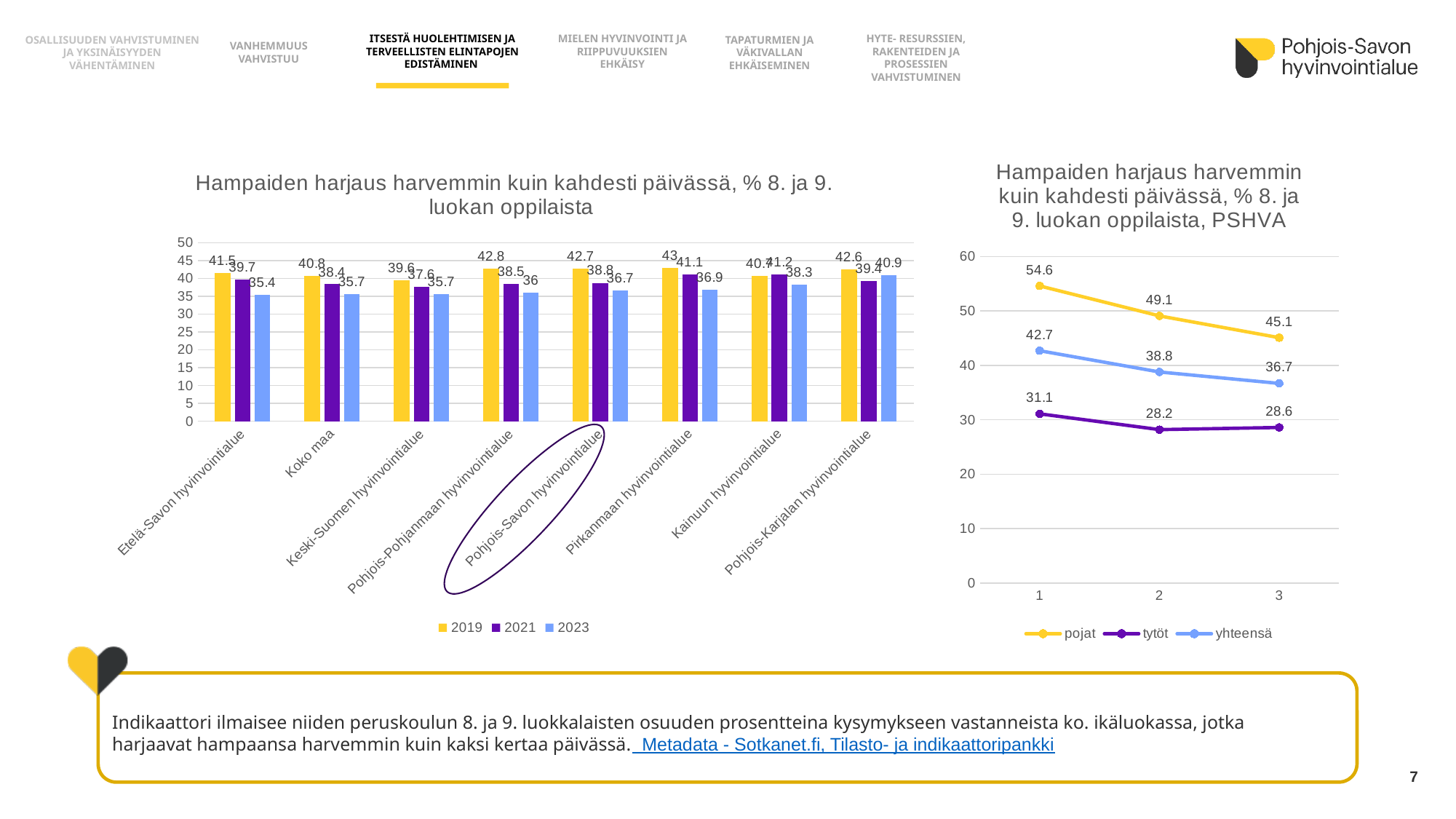
In the left bar chart, how many categories are shown on the x axis? 8 In the right chart (PSHVA), what is the value for tytöt at point 2? 28.2 In the right chart (PSHVA), what is the value for pojat at point 1? 54.6 In the left bar chart, what is the difference between the 2019 and 2023 values for Etelä-Savon hyvinvointialue? 6.1 In the left bar chart, which category has the highest 2023 value? Pohjois-Karjalan hyvinvointialue In the left bar chart, what is the 2019 value for Pirkanmaan hyvinvointialue? 43 In the right chart (PSHVA), does the pojat series rise or fall from point 1 to point 3? fall In the left bar chart, how many series does the legend list? 3 In the left bar chart, what is the 2023 value for Pohjois-Savon hyvinvointialue? 36.7 In the left bar chart, what is the 2021 value for Koko maa? 38.4 In the left bar chart, which category has the lowest 2019 value? Keski-Suomen hyvinvointialue What kind of chart is the right chart titled 'Hampaiden harjaus harvemmin kuin kahdesti päivässä, % 8. ja 9. luokan oppilaista, PSHVA'? line chart